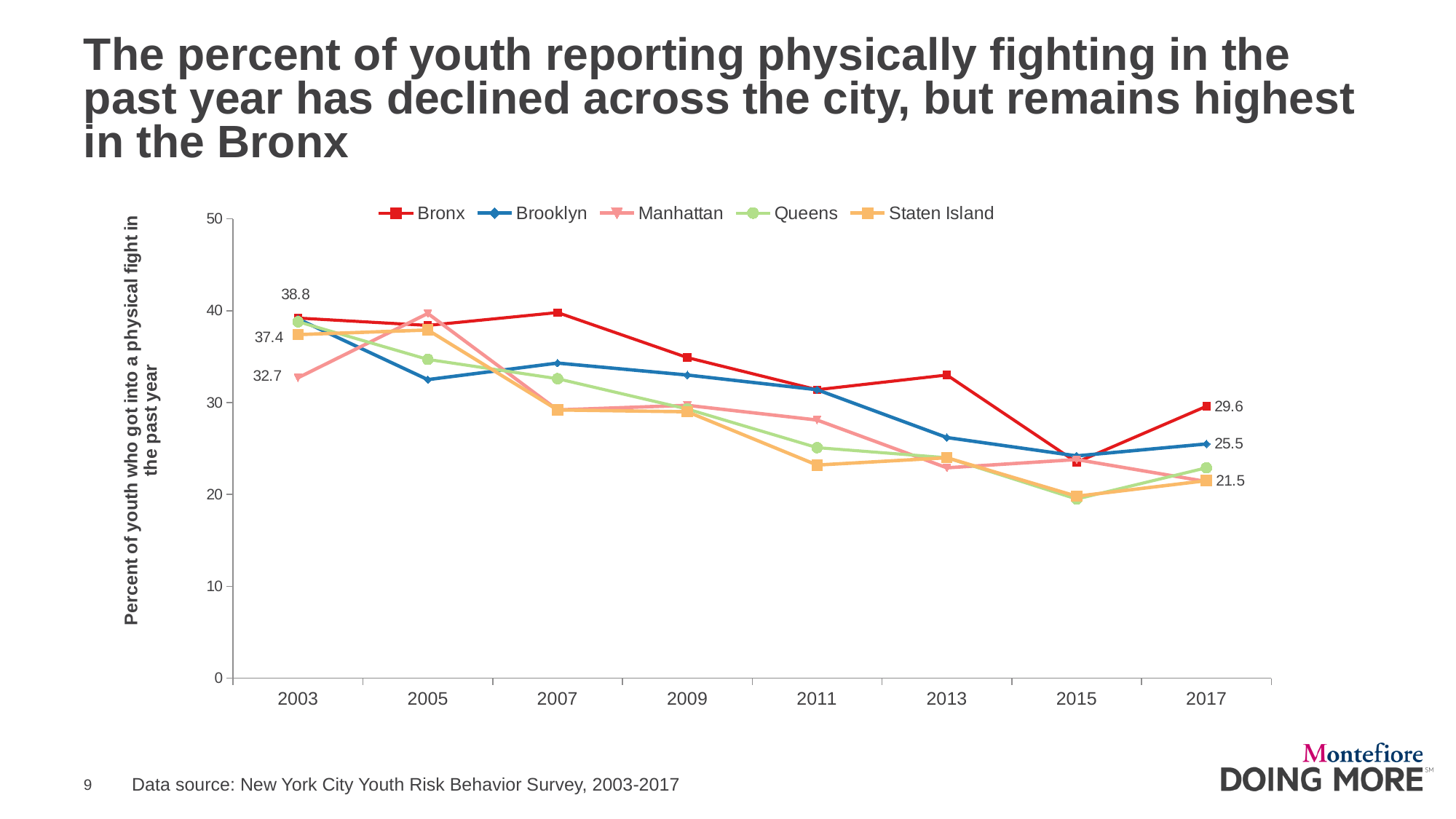
What is the value for the Bronx in 2017? 29.6 Which borough has the lowest value in 2003? Manhattan Does the Bronx line generally rise or fall from 2003 to 2017? Fall How many series does the legend list? 5 What type of chart is shown on the slide? Line chart Is the value for the Bronx in 2007 greater or less than 30? greater How many survey years are plotted along the x axis? 8 What is the value for Brooklyn in 2017? 25.5 What is the value for Manhattan in 2003? 32.7 What is the value for Staten Island in 2003? 37.4 What is the difference between the Bronx and Brooklyn values in 2017? 4.1 Which borough has the highest value in 2017? Bronx